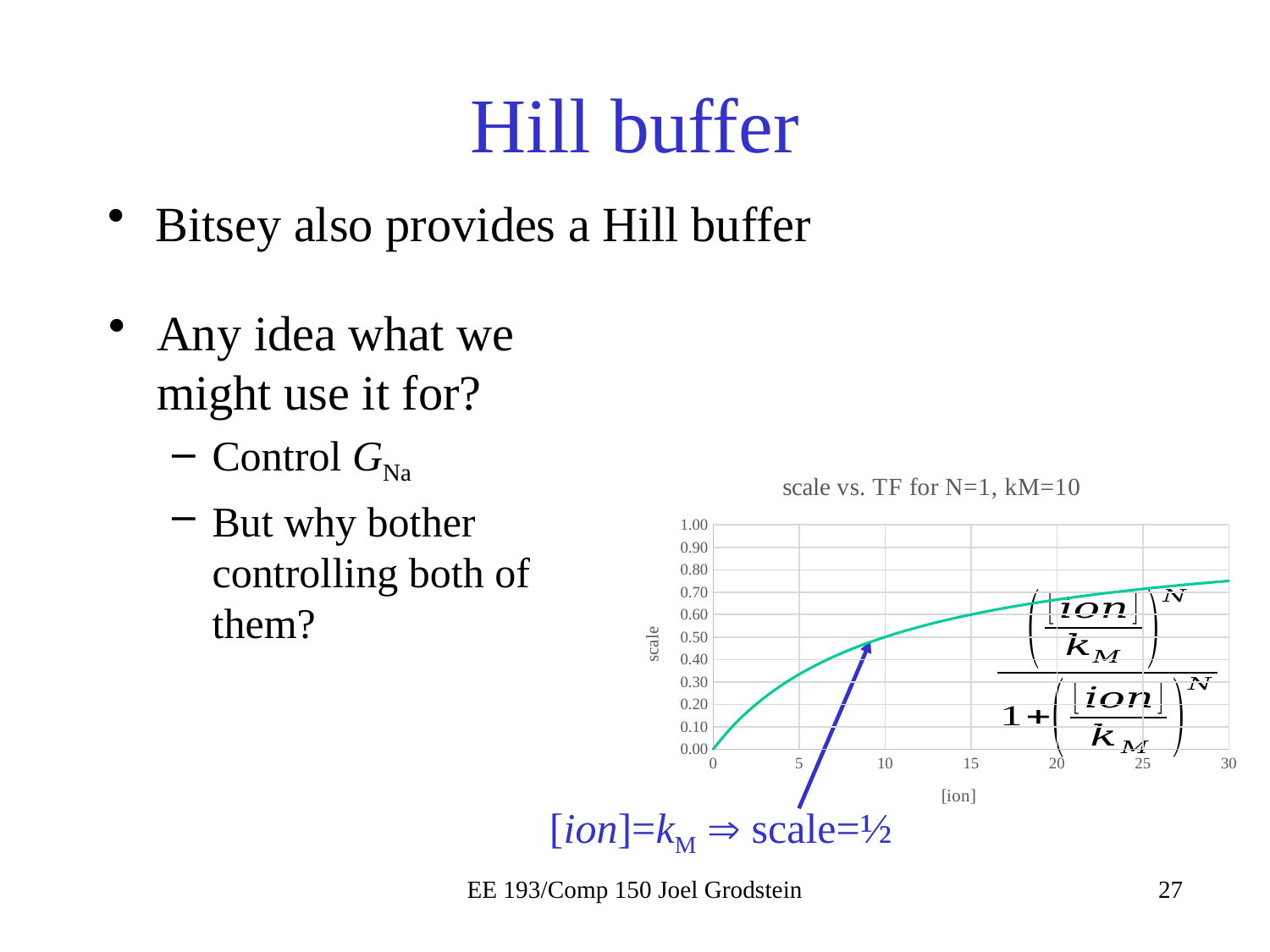
What is the scale value at [ion] = 0? 0.00 Is the scale value at [ion] = 20 greater or less than 0.60? greater Is the scale value at [ion] = 15 greater or less than 0.50? greater What kind of chart is shown on the slide? line chart Is the scale value at [ion] = 5 greater or less than 0.40? less According to the annotation on the chart, what is the scale value when [ion] equals kM (10)? ½ Does the scale value rise or fall as [ion] increases along the x axis? rise How many data series are plotted on the chart? 1 Which has the larger scale value, [ion] = 10 or [ion] = 25? [ion] = 25 What is the label of the x axis of the chart? [ion] What is the title of the chart? scale vs. TF for N=1, kM=10